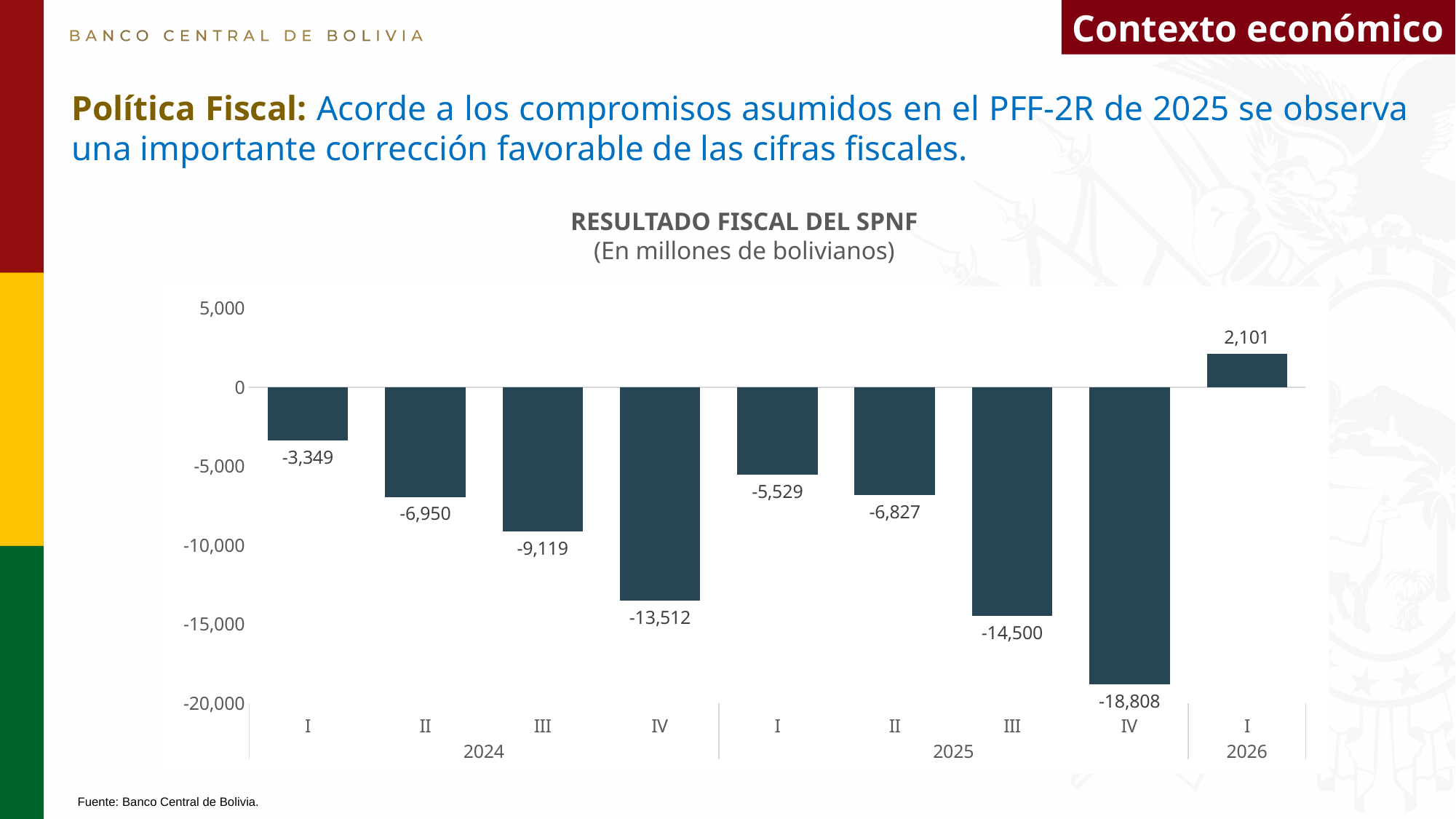
Which quarter has the lowest value? IV 2025 What is the value for quarter I of 2026? 2,101 Do the values fall or rise from quarter I to quarter IV of 2024? Fall Which quarter has the highest value? I 2026 Which is larger, the value for quarter I of 2024 or quarter I of 2025? I 2024 How many quarters are plotted in the chart? 9 What kind of chart is shown on the slide? Bar chart What is the title of the chart? RESULTADO FISCAL DEL SPNF What is the value for quarter II of 2025? -6,827 What is the value for quarter IV of 2024? -13,512 In what units are the chart values expressed? Millones de bolivianos What is the difference between the values for quarter IV of 2025 and quarter IV of 2024? 5,296